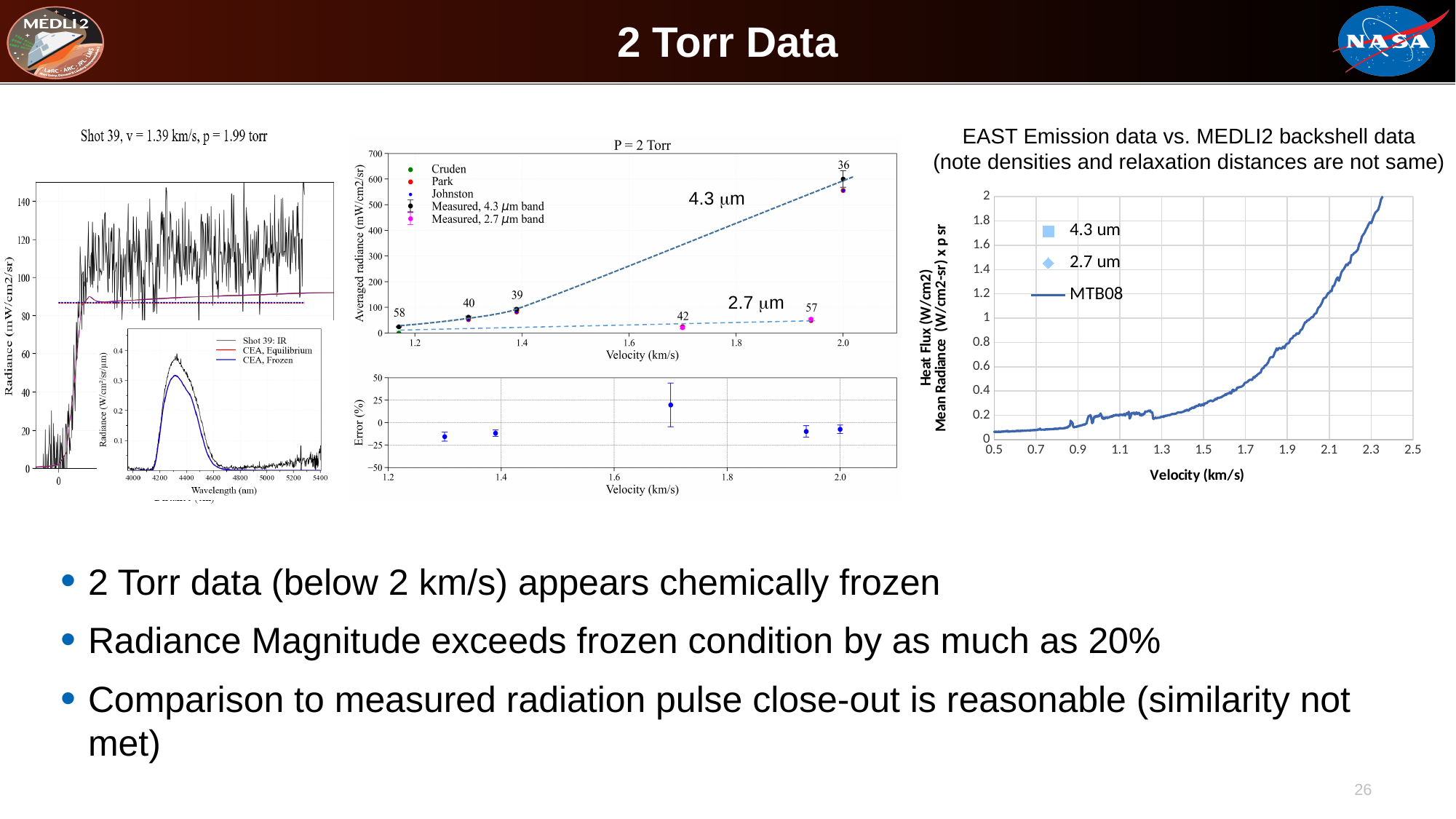
In the middle chart titled 'P = 2 Torr', how many measured 4.3 µm band data points are plotted? 4 In the right-hand chart (EAST Emission data vs. MEDLI2 backshell data), is the MTB08 value at a velocity of 1.5 km/s greater or less than 0.6? less In the Error (%) chart below the 'P = 2 Torr' chart, is the error at a velocity of about 1.7 km/s greater or less than 0? greater What is the x-axis label of the right-hand chart (EAST Emission data vs. MEDLI2 backshell data)? Velocity (km/s) What kind of chart is the right-hand chart titled 'EAST Emission data vs. MEDLI2 backshell data'? line chart How many series does the legend of the right-hand chart (EAST Emission data vs. MEDLI2 backshell data) list? 3 In the middle chart titled 'P = 2 Torr', which band has the higher averaged radiance at a velocity of 2.0 km/s, the 4.3 µm band or the 2.7 µm band? 4.3 µm band In the right-hand chart (EAST Emission data vs. MEDLI2 backshell data), does the MTB08 line rise or fall as velocity increases? rises How many entries does the legend of the middle chart titled 'P = 2 Torr' list? 5 In the middle chart titled 'P = 2 Torr', is the measured 4.3 µm band radiance at 2.0 km/s greater or less than 500 mW/cm2/sr? greater In the middle chart titled 'P = 2 Torr', does the 4.3 µm band radiance rise or fall as velocity increases? rises